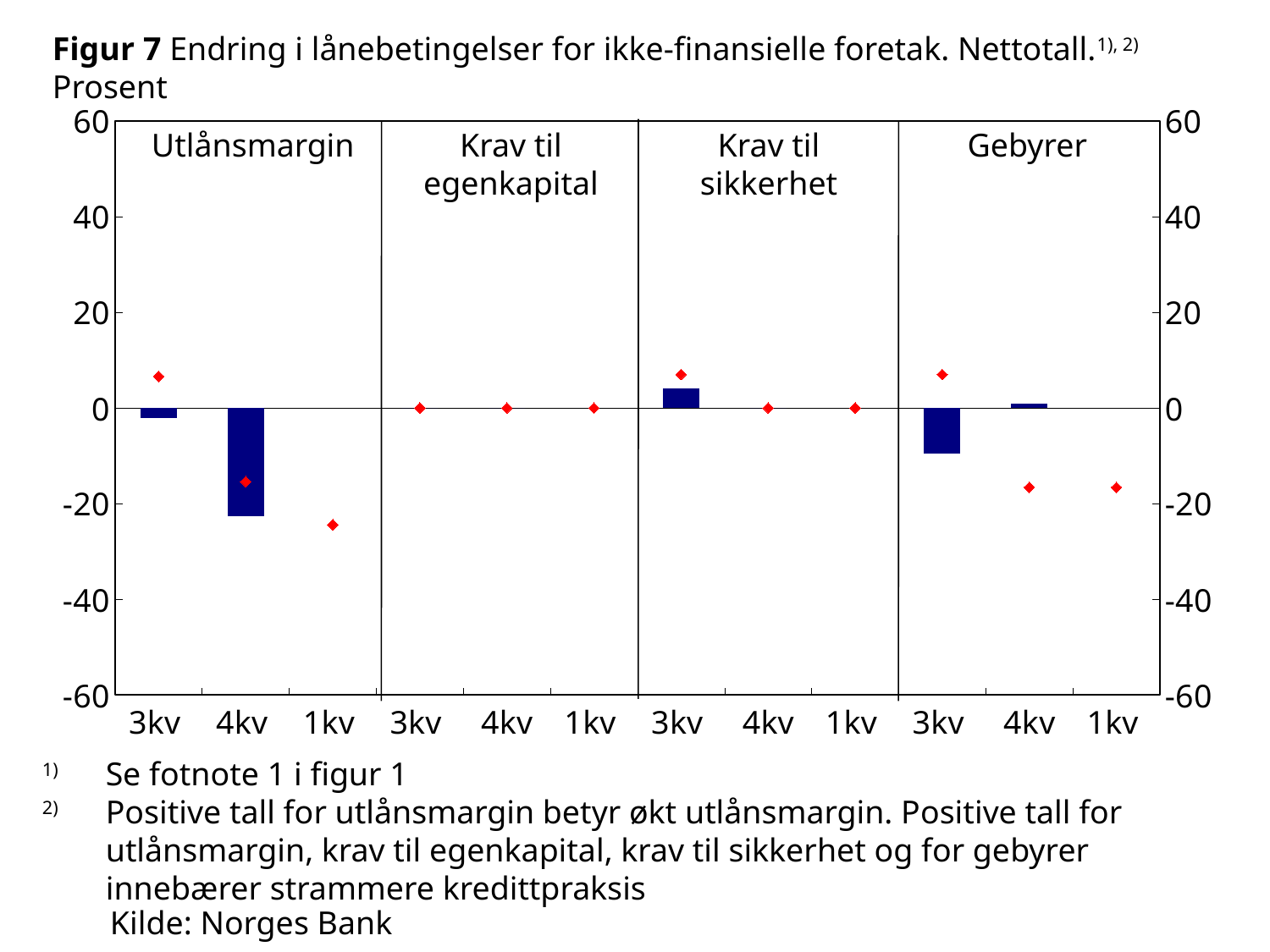
What is the value of the red marker for 4kv in the Krav til sikkerhet panel? 0 Is the bar for 4kv in the Utlånsmargin panel greater or less than -10? less How many lending-condition panels does the chart have? 4 How many quarters are shown on the x axis within each panel? 3 Is the red marker for 1kv in the Utlånsmargin panel greater or less than -20? less What is the value of the red marker for 3kv in the Krav til egenkapital panel? 0 Is the red marker for 4kv in the Gebyrer panel greater or less than -10? less What kind of chart is shown in Figur 7? combination chart (bars with diamond markers) Which quarter has the lowest bar in the Utlånsmargin panel? 4kv Do the red markers in the Utlånsmargin panel rise or fall from 3kv to 1kv? fall Which is lower: the bar for 4kv in the Utlånsmargin panel or the bar for 3kv in the Gebyrer panel? 4kv in Utlånsmargin